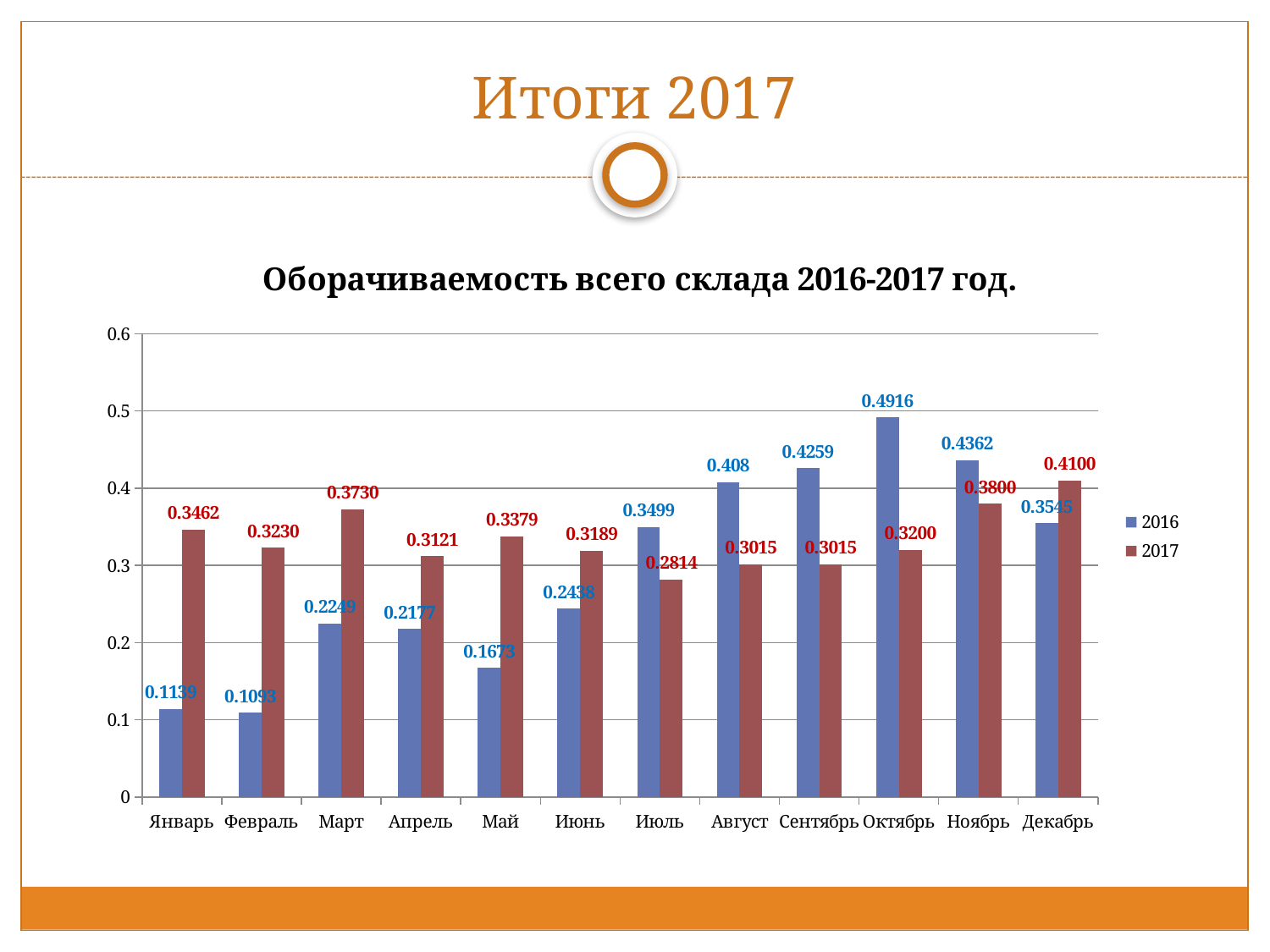
What is the value for 2016 in Октябрь? 0.4916 What is the value for 2016 in Май? 0.1673 Which month has the highest value for the 2017 series? Декабрь Which month has the highest value for the 2016 series? Октябрь What is the value for 2017 in Март? 0.3730 What kind of chart is shown on the slide? Bar chart Which month has the lowest value for the 2016 series? Февраль In Январь, which series has the larger value, 2016 or 2017? 2017 What is the difference between the 2016 and 2017 values in Октябрь? 0.1716 How many series does the legend list? 2 How many months are shown on the x axis? 12 Which month has the lowest value for the 2017 series? Июль